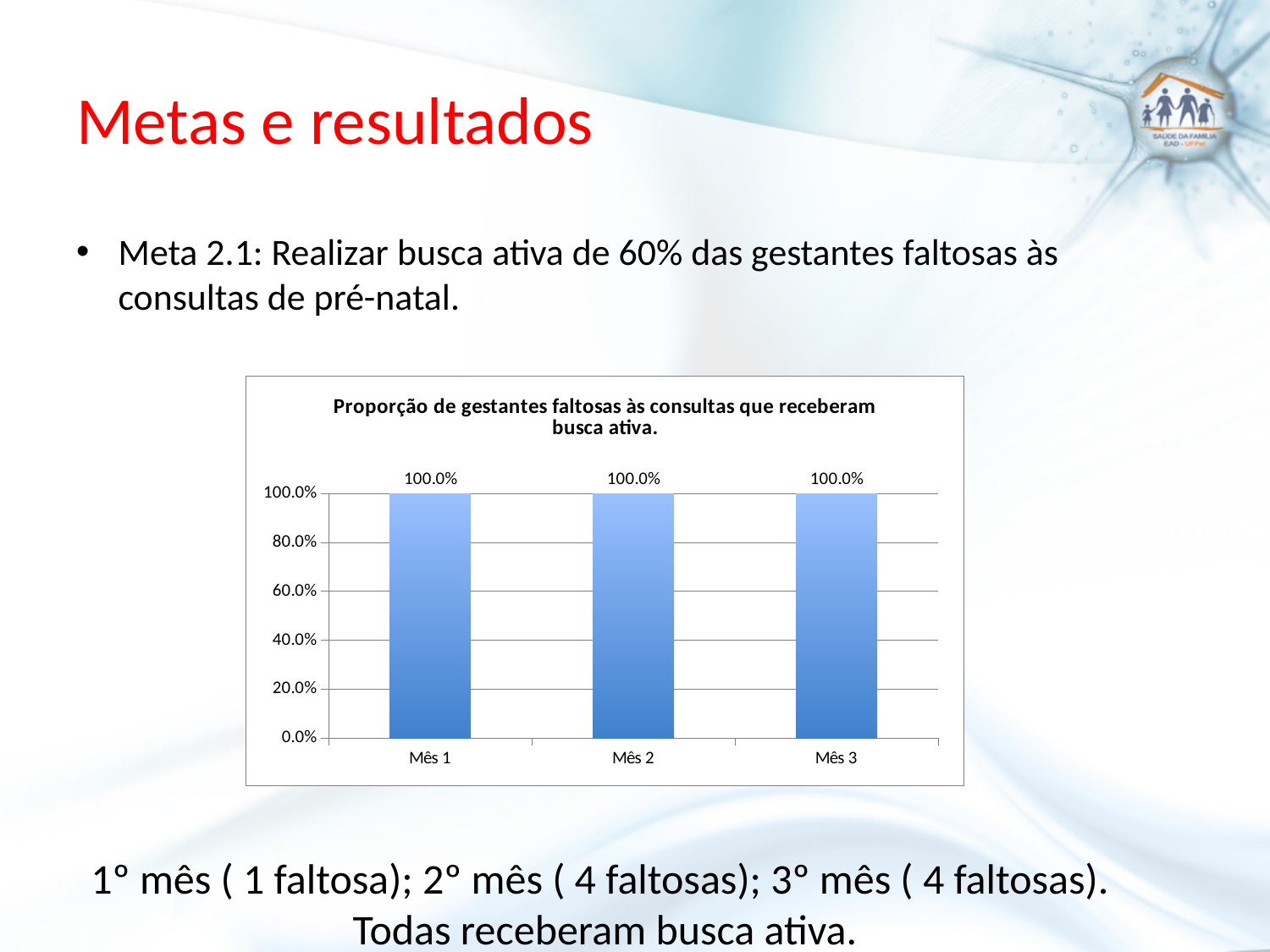
What is the value for Mês 2 in the chart? 100.0% What is the value for Mês 3 in the chart? 100.0% What is the value for Mês 1 in the chart? 100.0% Do the values rise, fall or stay the same from Mês 1 to Mês 3? Stay the same What is the difference between the values for Mês 1 and Mês 3? 0.0% Is the value for Mês 1 greater or less than 60.0%? greater What kind of chart is shown on the slide? Bar chart Which is larger, the value for Mês 1 or the value for Mês 2? They are equal How many categories are shown on the x axis of the chart? 3 Is the value for Mês 2 greater or less than 80.0%? greater What is the title of the chart? Proporção de gestantes faltosas às consultas que receberam busca ativa. What is the highest value shown on the y axis of the chart? 100.0%